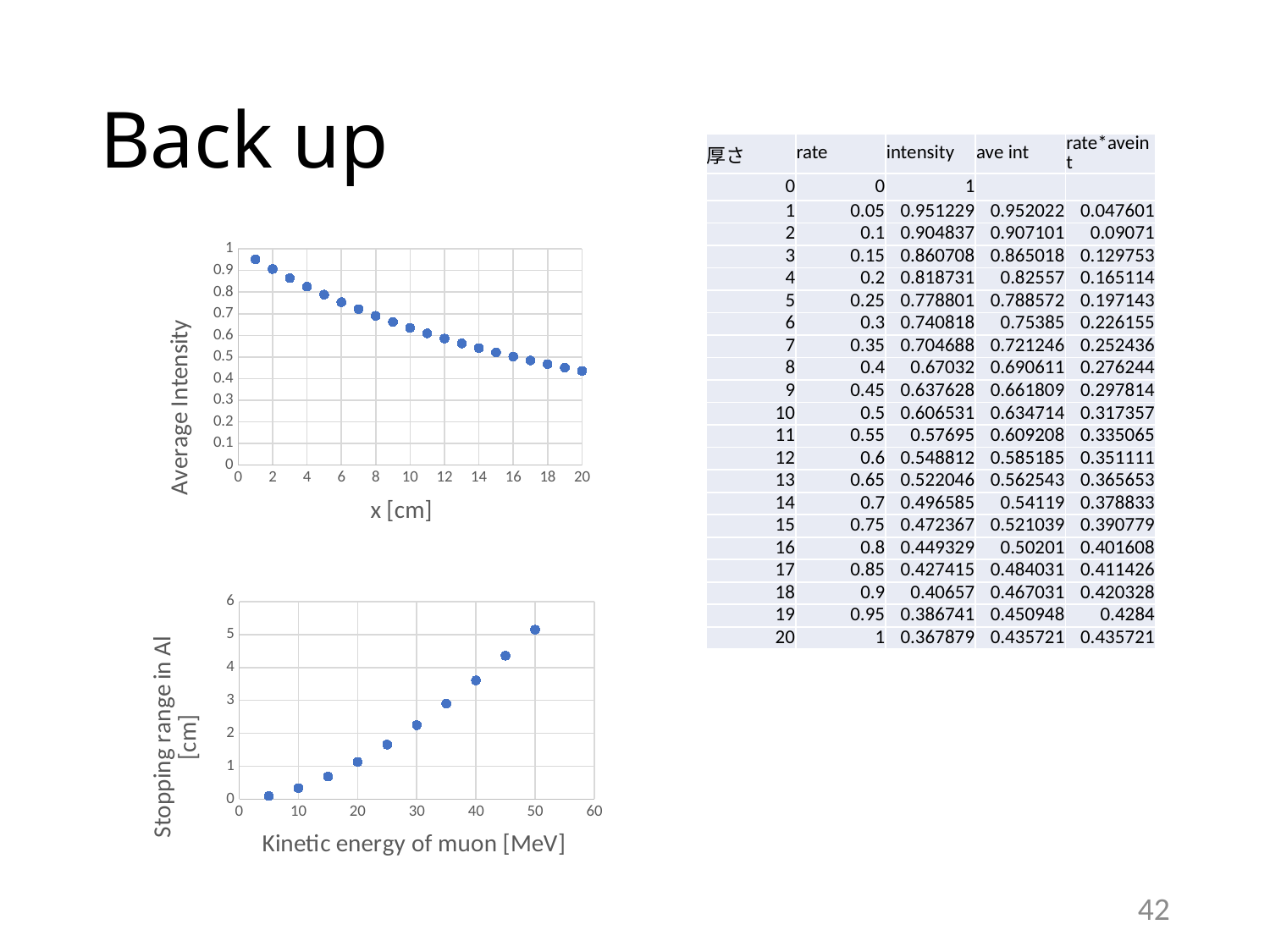
In the top chart (Average Intensity vs x [cm]), do the values rise or fall as x increases? fall In the top chart (Average Intensity vs x [cm]), is the value at x = 20 greater or less than 0.5? less How many data points are plotted in the bottom chart (Stopping range in Al vs Kinetic energy of muon)? 10 In the bottom chart (Stopping range in Al vs Kinetic energy of muon), do the values rise or fall as kinetic energy increases? rise What kind of chart is the bottom chart (Stopping range in Al vs Kinetic energy of muon)? scatter chart What kind of chart is the top chart (Average Intensity vs x [cm])? scatter chart In the bottom chart (Stopping range in Al vs Kinetic energy of muon), which has the larger stopping range: 20 MeV or 40 MeV? 40 MeV In the top chart (Average Intensity vs x [cm]), is the value at x = 2 greater or less than 0.8? greater In the bottom chart (Stopping range in Al vs Kinetic energy of muon), is the stopping range at 10 MeV greater or less than 1? less How many data points are plotted in the top chart (Average Intensity vs x [cm])? 20 In the top chart (Average Intensity vs x [cm]), at which x value is the average intensity lowest? 20 What is the x-axis title of the bottom chart? Kinetic energy of muon [MeV]